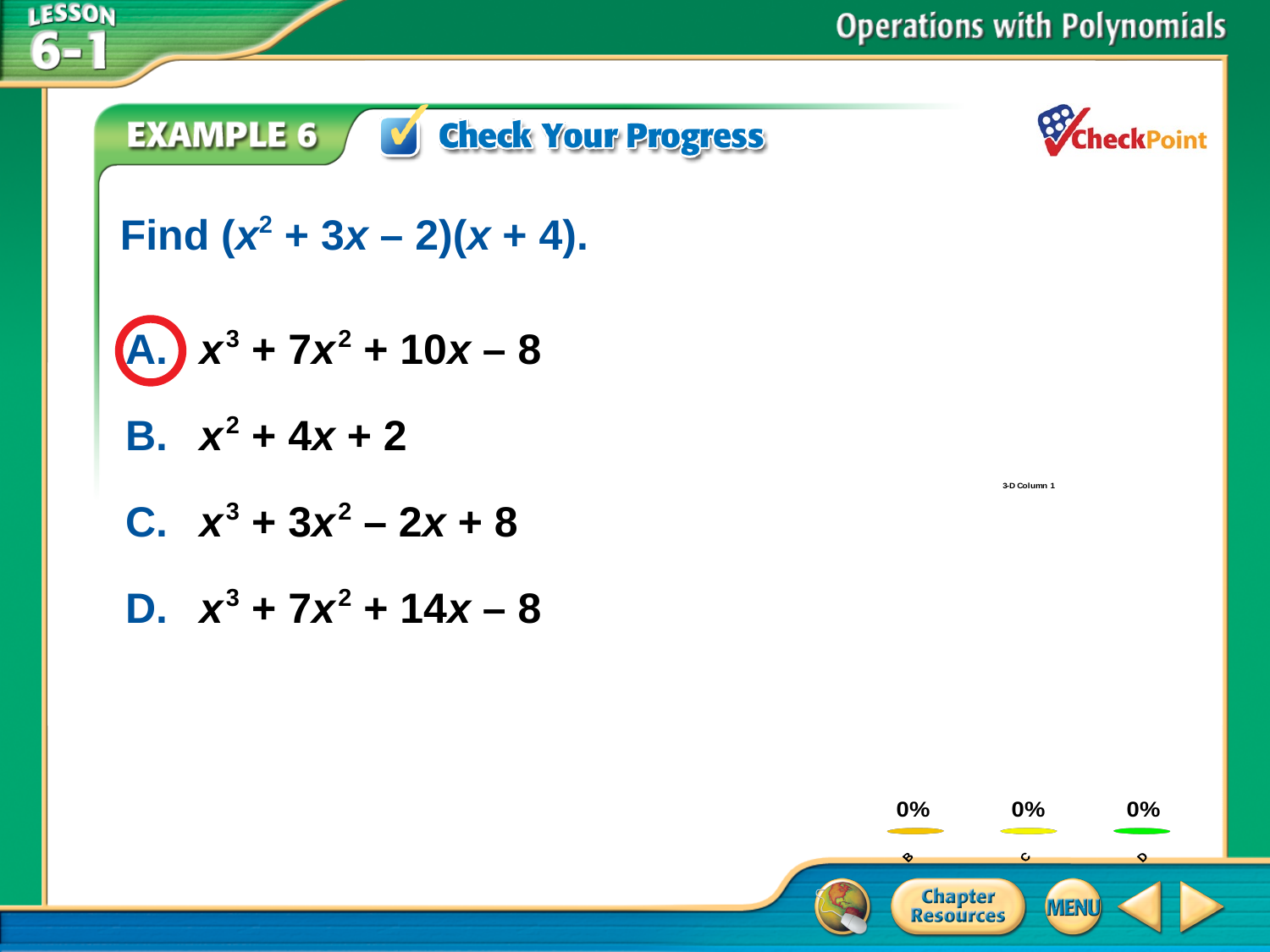
What value is shown for category D in the chart at the bottom right of the slide? 0% What kind of chart is shown at the bottom right of the slide? bar chart What value is shown for category B in the chart at the bottom right of the slide? 0% Is the value for C in the chart at the bottom right of the slide greater or less than 50%? less What is the difference between the values for B and D in the chart at the bottom right of the slide? 0% What value is shown for category C in the chart at the bottom right of the slide? 0%